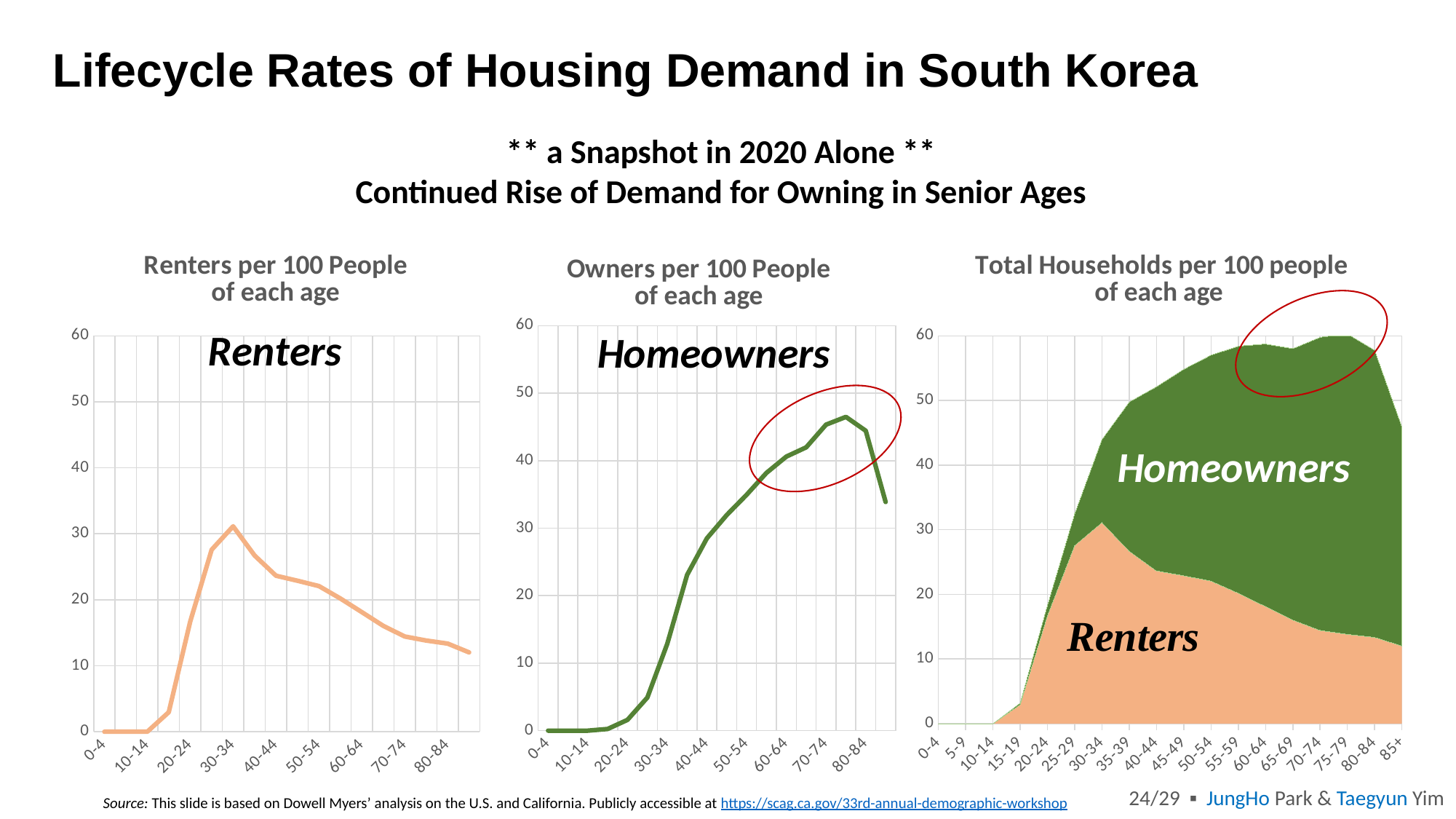
How many age groups are shown on the x axis of the 'Total Households per 100 people of each age' chart? 18 What kind of chart is the 'Renters per 100 People of each age' chart? line chart In the 'Owners per 100 People of each age' chart, is the value for 30-34 greater or less than 10? greater In the 'Renters per 100 People of each age' chart, is the value for 80-84 greater or less than 20? less In the 'Owners per 100 People of each age' chart, do the values rise or fall from 20-24 to 70-74? rise In the 'Total Households per 100 people of each age' chart, what colour is the Homeowners area? green In the 'Owners per 100 People of each age' chart, which age group has a larger value, 40-44 or 60-64? 60-64 In the 'Renters per 100 People of each age' chart, which age group has a larger value, 30-34 or 60-64? 30-34 What kind of chart is the 'Total Households per 100 people of each age' chart? area chart In the 'Renters per 100 People of each age' chart, do the values rise or fall from 30-34 to 80-84? fall In the 'Owners per 100 People of each age' chart, is the value for 70-74 greater or less than 40? greater